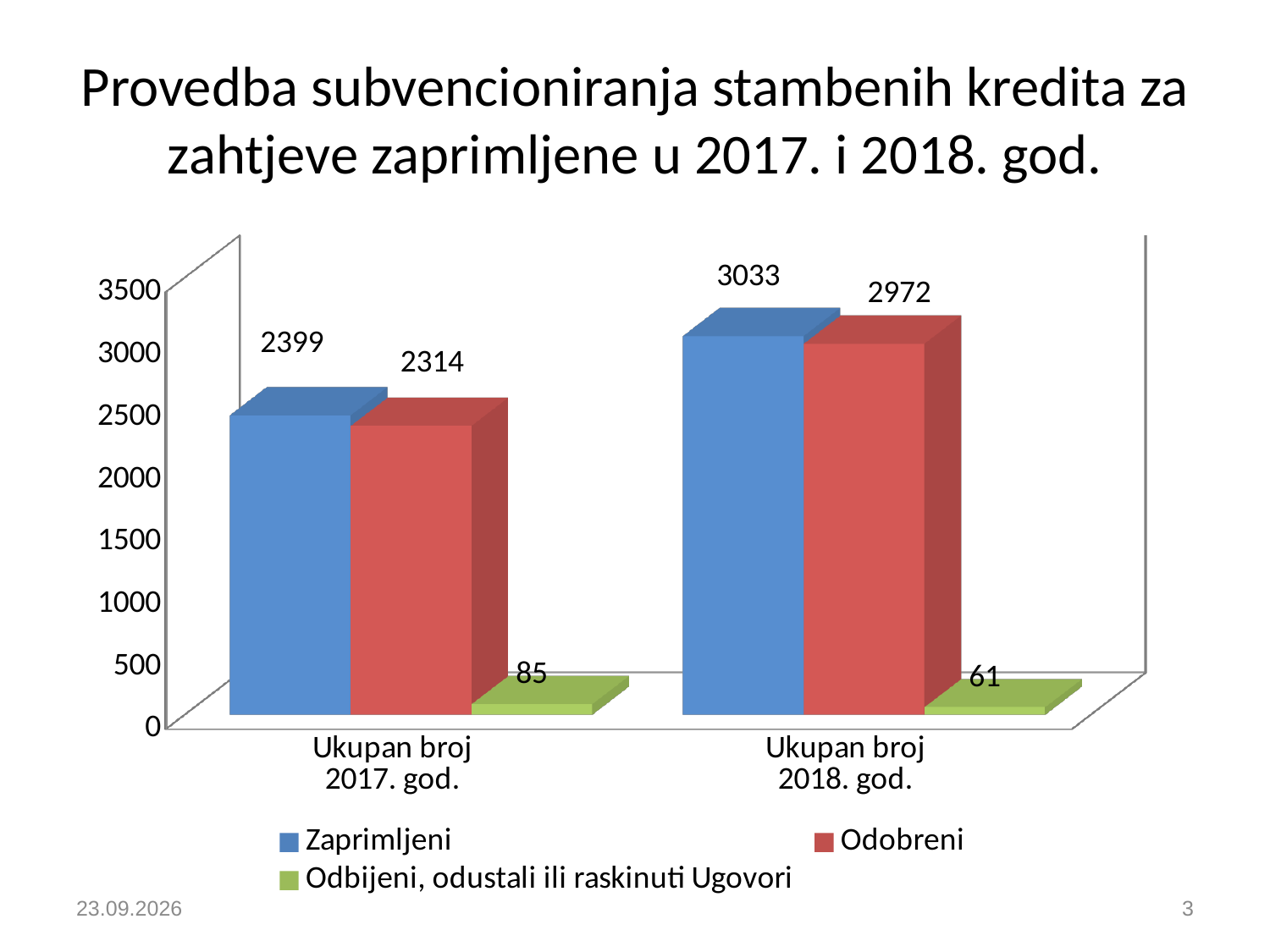
Which category has the highest Zaprimljeni value? Ukupan broj 2018. god. What is the value of Odbijeni, odustali ili raskinuti Ugovori for Ukupan broj 2017. god.? 85 What is the difference between Zaprimljeni and Odobreni for Ukupan broj 2017. god.? 85 What kind of chart is shown on the slide? Bar chart What is the value of Zaprimljeni for Ukupan broj 2018. god.? 3033 What is the value of Odobreni for Ukupan broj 2018. god.? 2972 What is the value of Zaprimljeni for Ukupan broj 2017. god.? 2399 Is the Odobreni value for Ukupan broj 2018. god. greater or less than 2500? greater How many series does the legend list? 3 What is the difference between the Zaprimljeni values for 2018. god. and 2017. god.? 634 Which series has the lowest value for Ukupan broj 2018. god.? Odbijeni, odustali ili raskinuti Ugovori Which is larger: Odbijeni, odustali ili raskinuti Ugovori for 2017. god. or for 2018. god.? 2017. god.